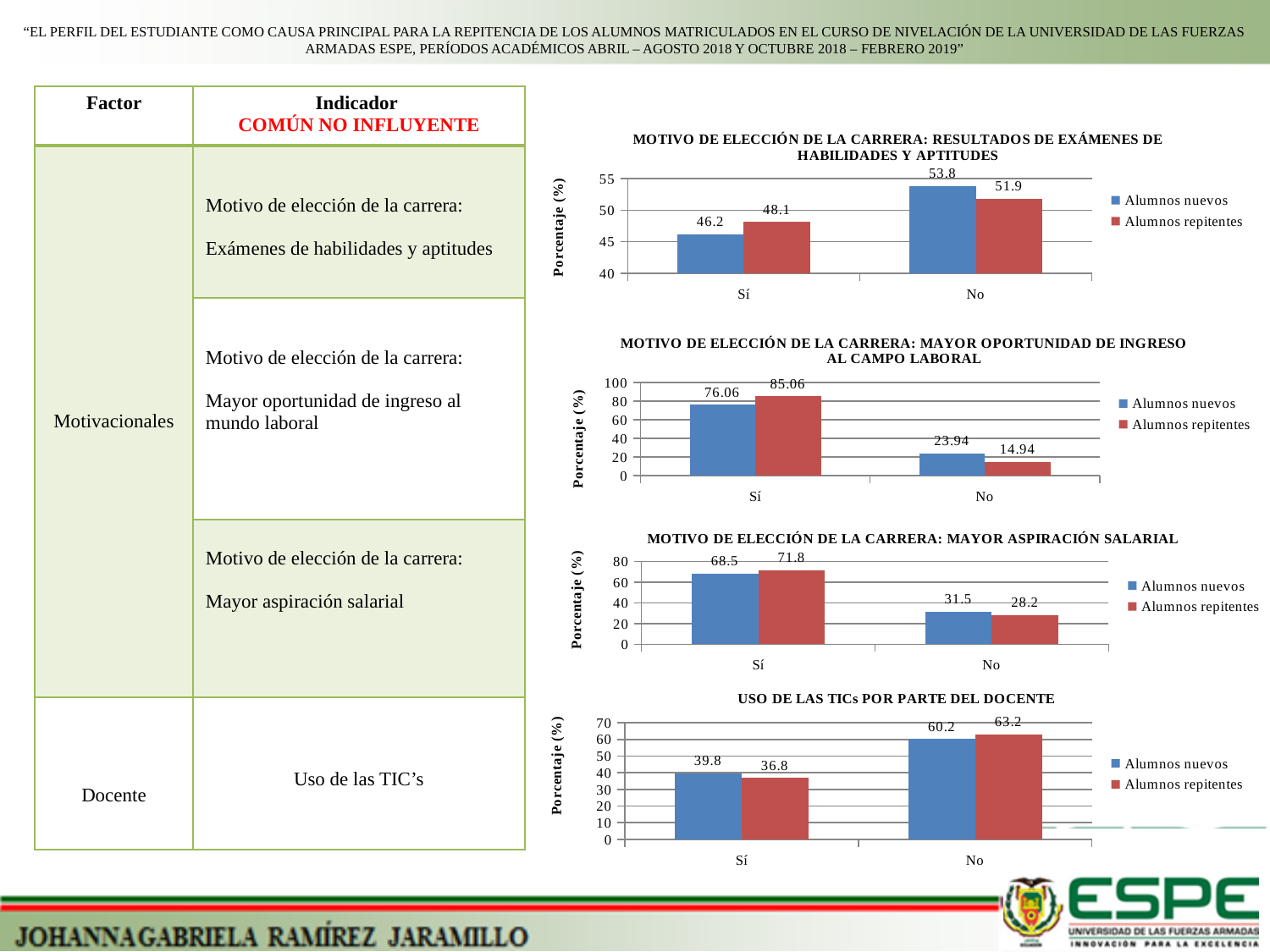
In the chart 'USO DE LAS TICs POR PARTE DEL DOCENTE', which bar has the highest value? Alumnos repitentes, No In the chart 'MOTIVO DE ELECCIÓN DE LA CARRERA: RESULTADOS DE EXÁMENES DE HABILIDADES Y APTITUDES', what is the value for Alumnos nuevos in the Sí category? 46.2 In the chart 'MOTIVO DE ELECCIÓN DE LA CARRERA: RESULTADOS DE EXÁMENES DE HABILIDADES Y APTITUDES', what is the value for Alumnos repitentes in the No category? 51.9 In the chart 'MOTIVO DE ELECCIÓN DE LA CARRERA: MAYOR ASPIRACIÓN SALARIAL', what is the value for Alumnos nuevos in the No category? 31.5 In the chart 'MOTIVO DE ELECCIÓN DE LA CARRERA: MAYOR OPORTUNIDAD DE INGRESO AL CAMPO LABORAL', which bar has the lowest value? Alumnos repitentes, No In the chart 'USO DE LAS TICs POR PARTE DEL DOCENTE', what is the value for Alumnos repitentes in the No category? 63.2 In the chart 'MOTIVO DE ELECCIÓN DE LA CARRERA: MAYOR OPORTUNIDAD DE INGRESO AL CAMPO LABORAL', what is the difference between Alumnos nuevos and Alumnos repitentes in the No category? 9 What kind of chart is 'MOTIVO DE ELECCIÓN DE LA CARRERA: MAYOR ASPIRACIÓN SALARIAL'? Bar chart In the chart 'MOTIVO DE ELECCIÓN DE LA CARRERA: MAYOR ASPIRACIÓN SALARIAL', what is the difference between Alumnos repitentes and Alumnos nuevos in the Sí category? 3.3 How many series does the legend list in the chart 'USO DE LAS TICs POR PARTE DEL DOCENTE'? 2 In the chart 'MOTIVO DE ELECCIÓN DE LA CARRERA: MAYOR ASPIRACIÓN SALARIAL', which series has the higher value in the Sí category? Alumnos repitentes In the chart 'MOTIVO DE ELECCIÓN DE LA CARRERA: MAYOR OPORTUNIDAD DE INGRESO AL CAMPO LABORAL', what is the value for Alumnos repitentes in the Sí category? 85.06